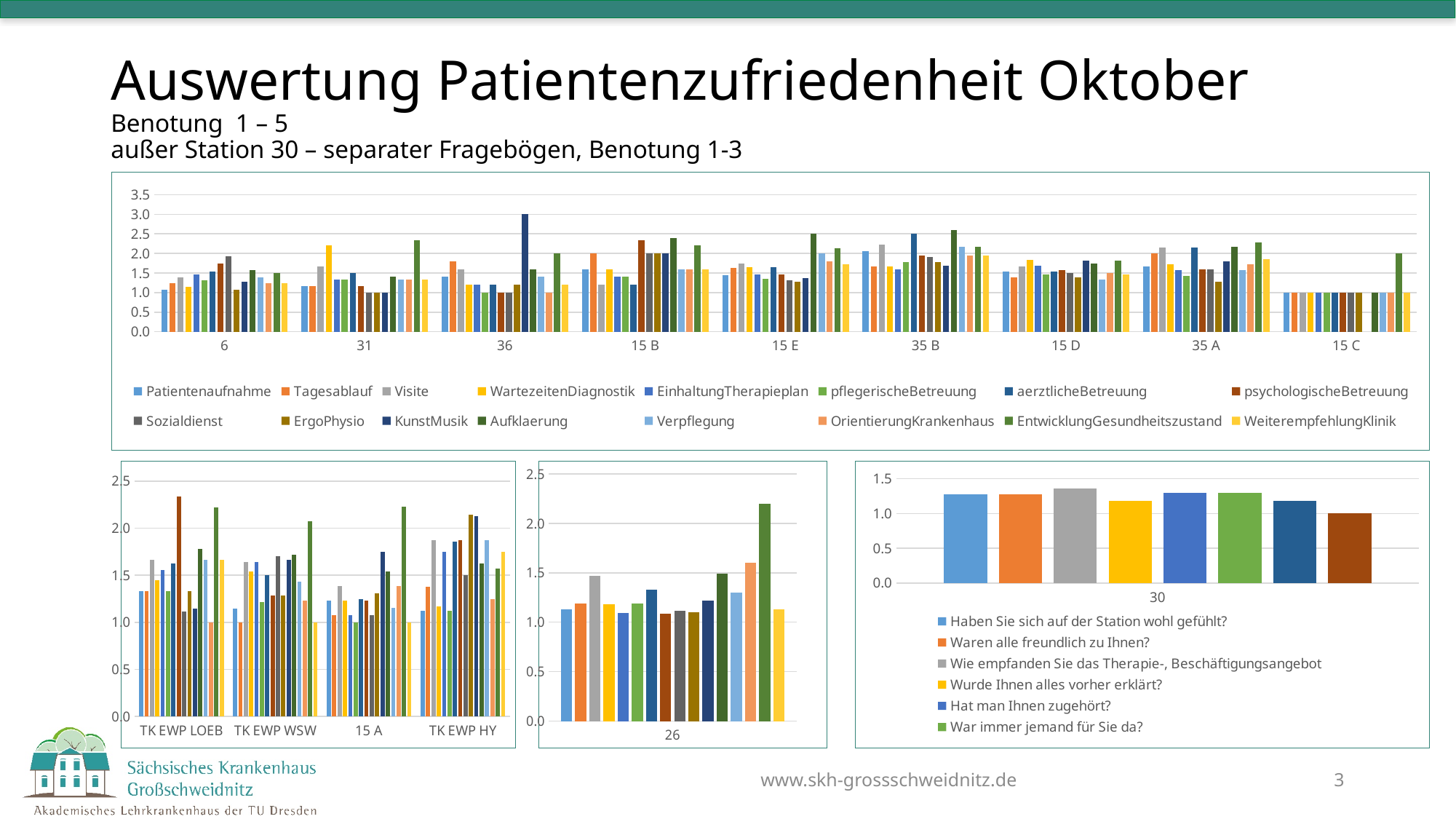
In the bottom-middle chart (station 26), is the tallest bar greater or less than 2.0? greater How many series does the legend of the bottom-right chart (station 30) list? 6 What is the category label on the x axis of the bottom-middle chart? 26 How many series does the legend of the large top chart list? 16 In the large top chart, is the value for psychologischeBetreuung at station 15 B greater or less than 2.0? greater In the large top chart, is the value for Patientenaufnahme at station 6 greater or less than 1.5? less What kind of chart is the large chart at the top of the slide? bar chart How many categories are shown on the x axis of the bottom-left chart? 4 How many stations (categories) are shown on the x axis of the large top chart? 9